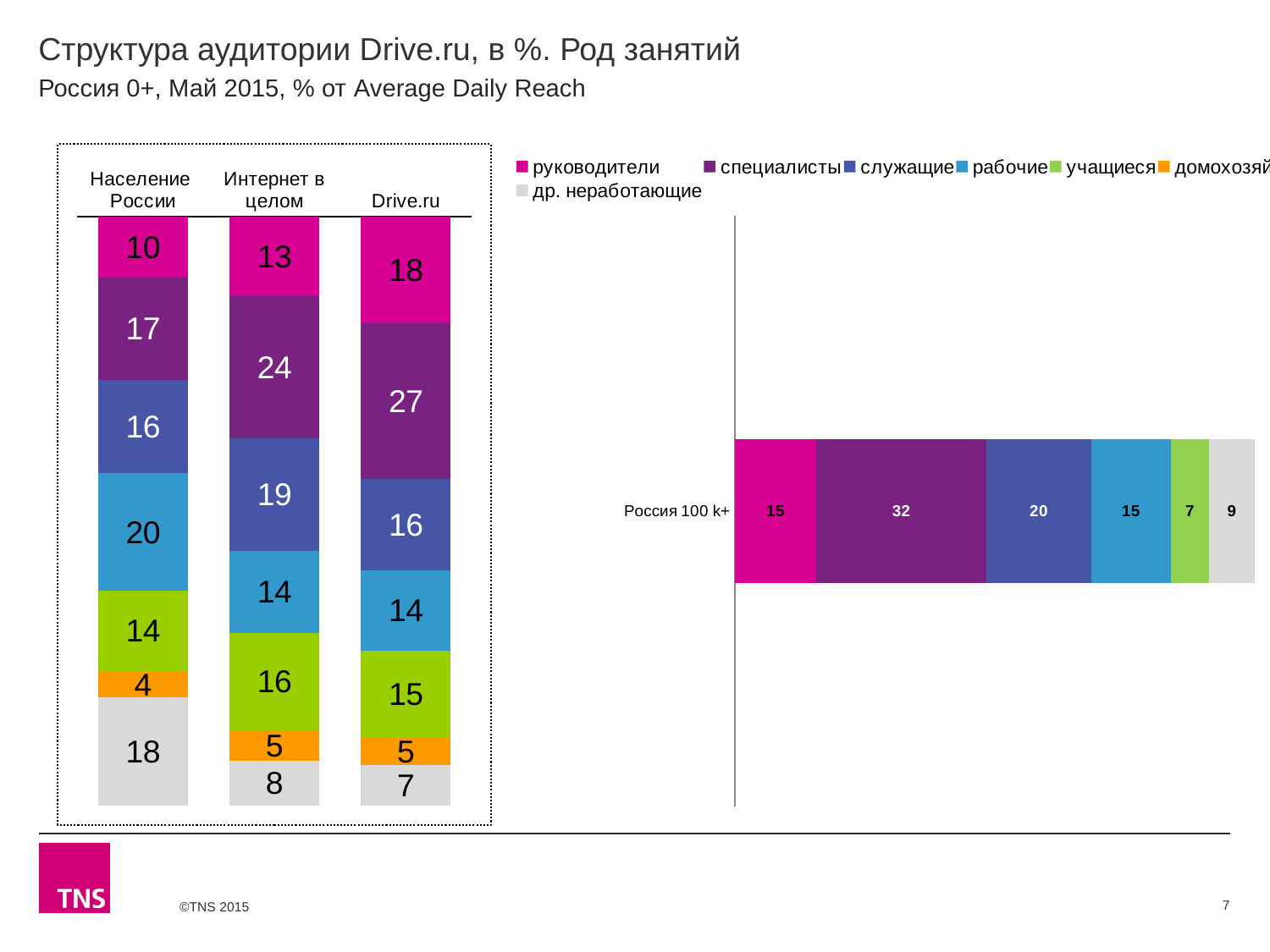
What kind of chart is the right chart (Россия 100 k+)? Stacked bar chart In the left chart, which is larger: учащиеся for Интернет в целом or учащиеся for Drive.ru? Интернет в целом In the right chart (Россия 100 k+), what is the value for специалисты? 32 In the left chart, which segment of the Население России bar is the smallest? домохозяйки How many series does the legend list? 7 In the left chart, what is the value for др. неработающие in the Интернет в целом bar? 8 In the left chart, what is the difference between the руководители values for Drive.ru and Население России? 8 In the left chart, what is the value for специалисты in the Drive.ru bar? 27 In the right chart (Россия 100 k+), which segment is the smallest? учащиеся In the left chart, what is the value for рабочие in the Население России bar? 20 In the left chart, which segment of the Интернет в целом bar is the largest? специалисты How many bars (categories) are shown in the left chart? 3